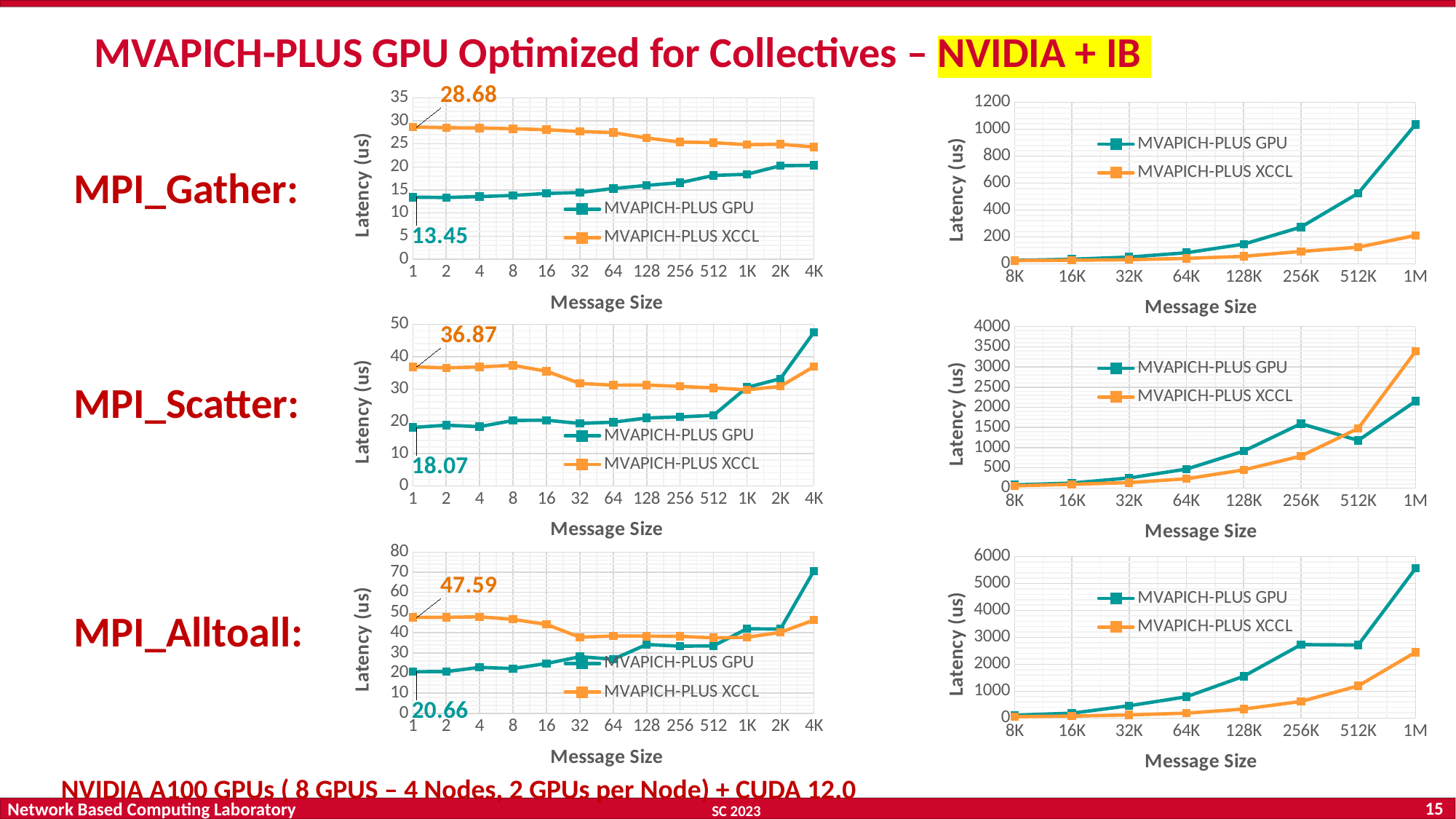
In the MPI_Alltoall row, on the left chart, what is the difference between the labelled MVAPICH-PLUS XCCL and MVAPICH-PLUS GPU latencies at message size 1? 26.93 In the MPI_Gather row, on the left chart, what is the difference between the labelled MVAPICH-PLUS XCCL and MVAPICH-PLUS GPU latencies at message size 1? 15.23 In the MPI_Scatter row, on the right chart, how many message sizes are shown on the x axis? 8 In the MPI_Gather row, on the left chart, what is the latency of MVAPICH-PLUS GPU at message size 1? 13.45 In the MPI_Gather row, on the right chart, how many series does the legend list? 2 In the MPI_Gather row, on the right chart, is the latency of MVAPICH-PLUS GPU at message size 1M greater or less than 800? greater In the MPI_Scatter row, on the right chart, which series has the higher latency at message size 1M? MVAPICH-PLUS XCCL What kind of chart is used in the MPI_Alltoall row, left chart? Line chart In the MPI_Scatter row, on the left chart, what is the labelled latency of MVAPICH-PLUS GPU at message size 1? 18.07 In the MPI_Alltoall row, on the right chart, does the MVAPICH-PLUS XCCL latency rise or fall as message size increases from 8K to 1M? Rise In the MPI_Gather row, on the left chart, what is the latency of MVAPICH-PLUS XCCL at message size 1? 28.68 In the MPI_Scatter row, on the left chart, what is the labelled latency of MVAPICH-PLUS XCCL at message size 1? 36.87